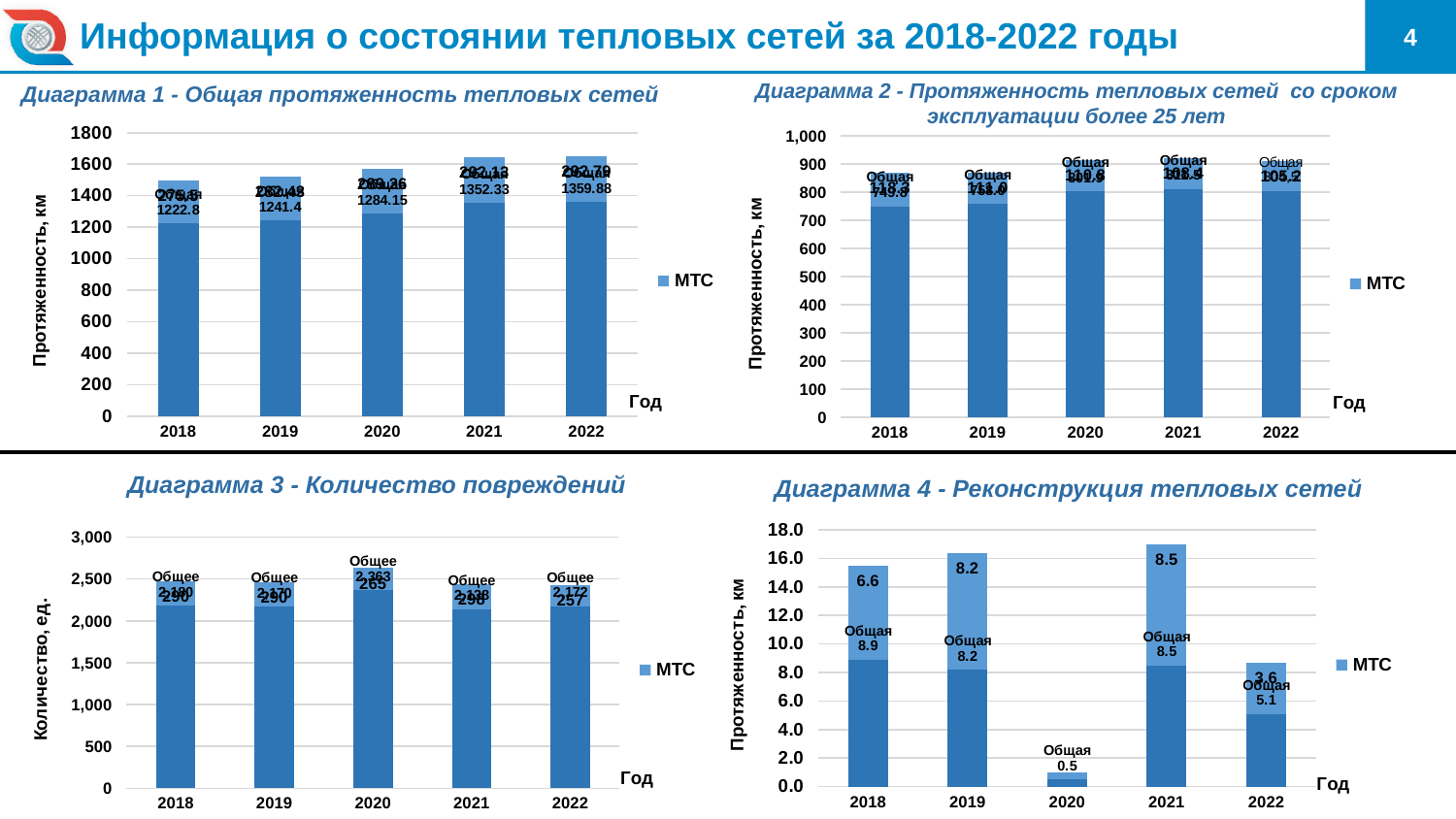
On Диаграмма 2 - Протяженность тепловых сетей со сроком эксплуатации более 25 лет, is the total height of the 2018 bar greater or less than 900? less What kind of chart is Диаграмма 4 - Реконструкция тепловых сетей? Stacked bar chart On Диаграмма 1 - Общая протяженность тепловых сетей, what is the value printed on the lower segment of the 2018 bar? 1222.8 On Диаграмма 2 - Протяженность тепловых сетей со сроком эксплуатации более 25 лет, what is the value printed on the lower segment of the 2018 bar? 749.8 On Диаграмма 1 - Общая протяженность тепловых сетей, is the total height of the 2022 bar greater or less than 1600? greater On Диаграмма 4 - Реконструкция тепловых сетей, which year has the shortest bar? 2020 On Диаграмма 4 - Реконструкция тепловых сетей, what is the total of the two segments of the 2022 bar (3.6 and 5.1)? 8.7 On Диаграмма 1 - Общая протяженность тепловых сетей, what is the value printed on the lower segment of the 2022 bar? 1359.88 On Диаграмма 3 - Количество повреждений, what is the 'Общее' value printed for 2020? 2,363 On Диаграмма 4 - Реконструкция тепловых сетей, what is the value printed on the upper segment of the 2018 bar? 6.6 On Диаграмма 1 - Общая протяженность тепловых сетей, how many years are shown on the x axis? 5 On Диаграмма 3 - Количество повреждений, which year has the tallest bar? 2020